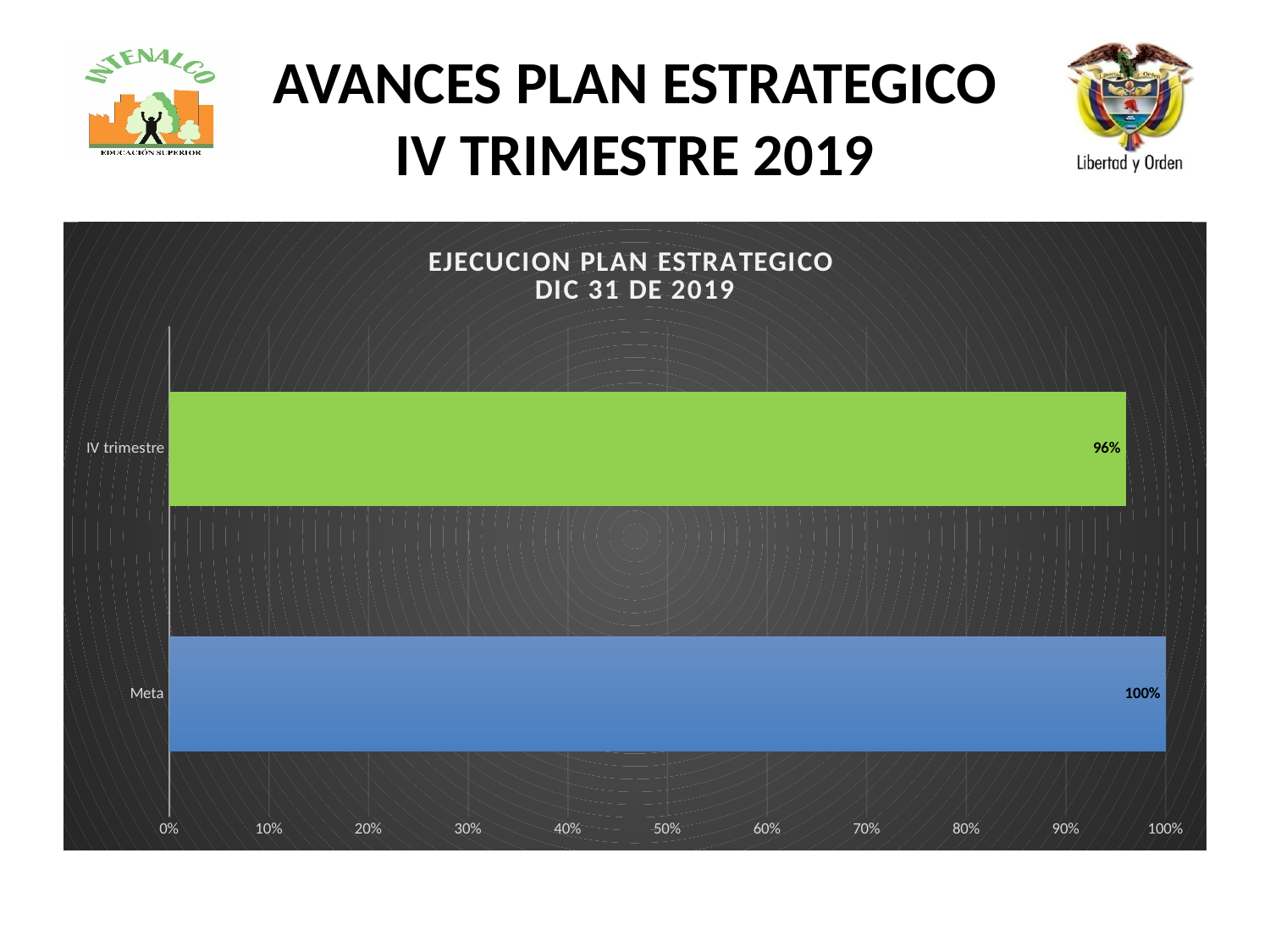
What kind of chart is shown on the slide? bar chart How many categories are shown in the chart? 2 Which category has the highest value? Meta What is the title of the chart? EJECUCION PLAN ESTRATEGICO DIC 31 DE 2019 What colour is the bar for IV trimestre? green What is the difference between the value for Meta and the value for IV trimestre? 4% Which category has the lowest value? IV trimestre What is the value for Meta? 100% Is the value for IV trimestre greater or less than 90%? greater Which is larger, the value for Meta or the value for IV trimestre? Meta What is the maximum value shown on the horizontal axis? 100% What is the value for IV trimestre? 96%